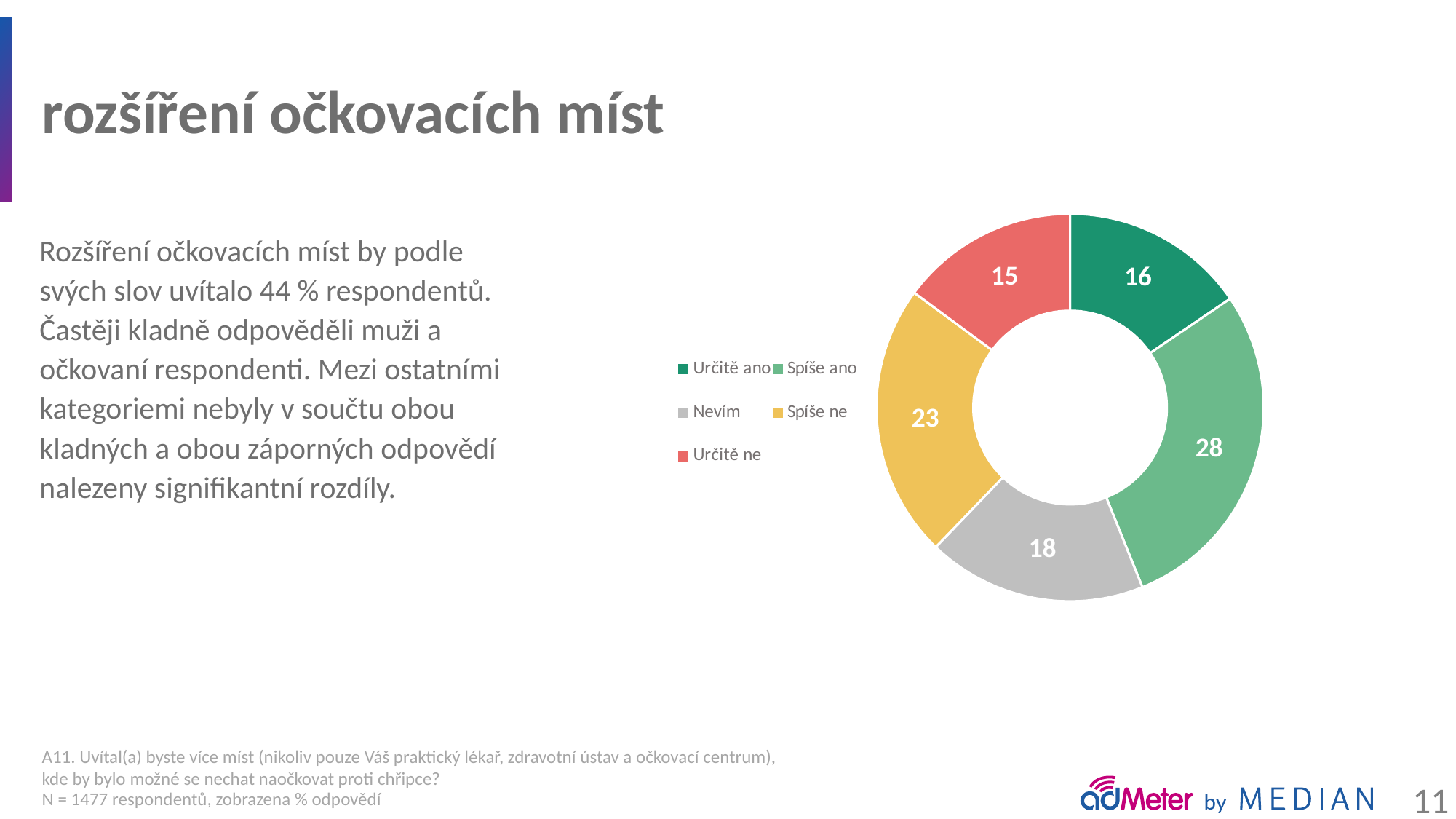
Which category has the smallest slice in the doughnut chart? Určitě ne Which colour represents "Spíše ne" in the doughnut chart? Yellow What value is shown for "Spíše ano" in the doughnut chart? 28 What type of chart is shown on the slide? Doughnut chart What value is shown for "Určitě ne" in the doughnut chart? 15 How many entries does the chart legend list? 5 What value is shown for "Nevím" in the doughnut chart? 18 Which category has the largest slice in the doughnut chart? Spíše ano What is the difference between the values for "Spíše ne" and "Určitě ano"? 7 What is the combined value of "Určitě ano" and "Spíše ano"? 44 How many categories does the doughnut chart show? 5 Which is larger, the value for "Spíše ne" or the value for "Nevím"? Spíše ne